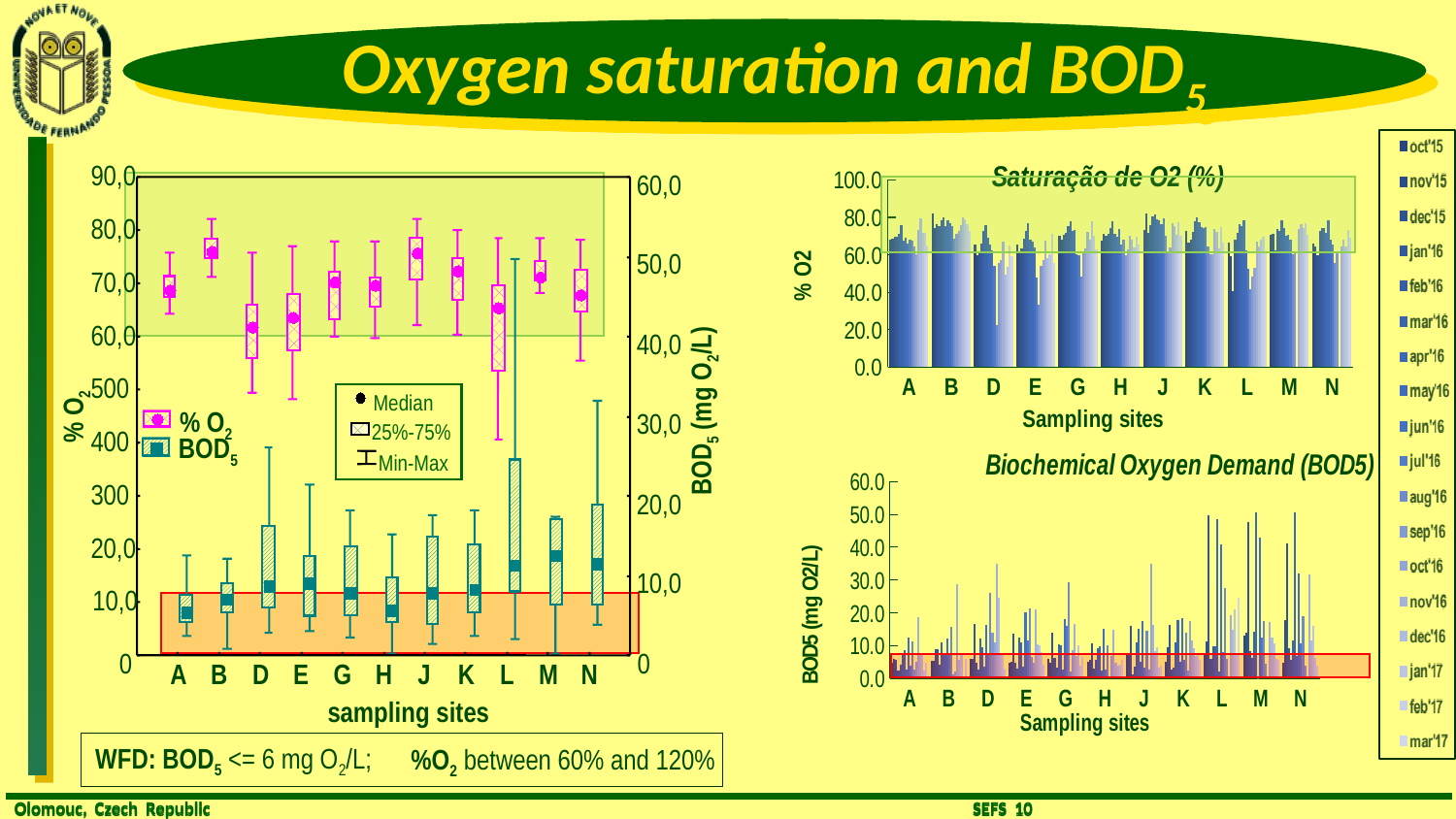
In the left chart, is the median % O2 value for site B greater or less than 70? greater What kind of chart is the top-right chart titled 'Saturação de O2 (%)'? bar chart What is the title of the bottom-right chart? Biochemical Oxygen Demand (BOD5) How many sampling sites are shown on the x axis of the left chart? 11 In the left chart, is the median % O2 value for site D greater or less than 70? less In the left chart, is the median BOD5 value for site M greater or less than 10 mg O2/L? greater In the left chart, which sampling site has the highest maximum (top whisker) BOD5 value? L How many sampling sites are shown on the x axis of the top-right 'Saturação de O2 (%)' chart? 11 What is the maximum value shown on the y axis of the bottom-right BOD5 chart? 60,0 What is the first month listed in the legend on the right side of the slide? oct'15 How many series (months) does the legend on the right side of the slide list? 18